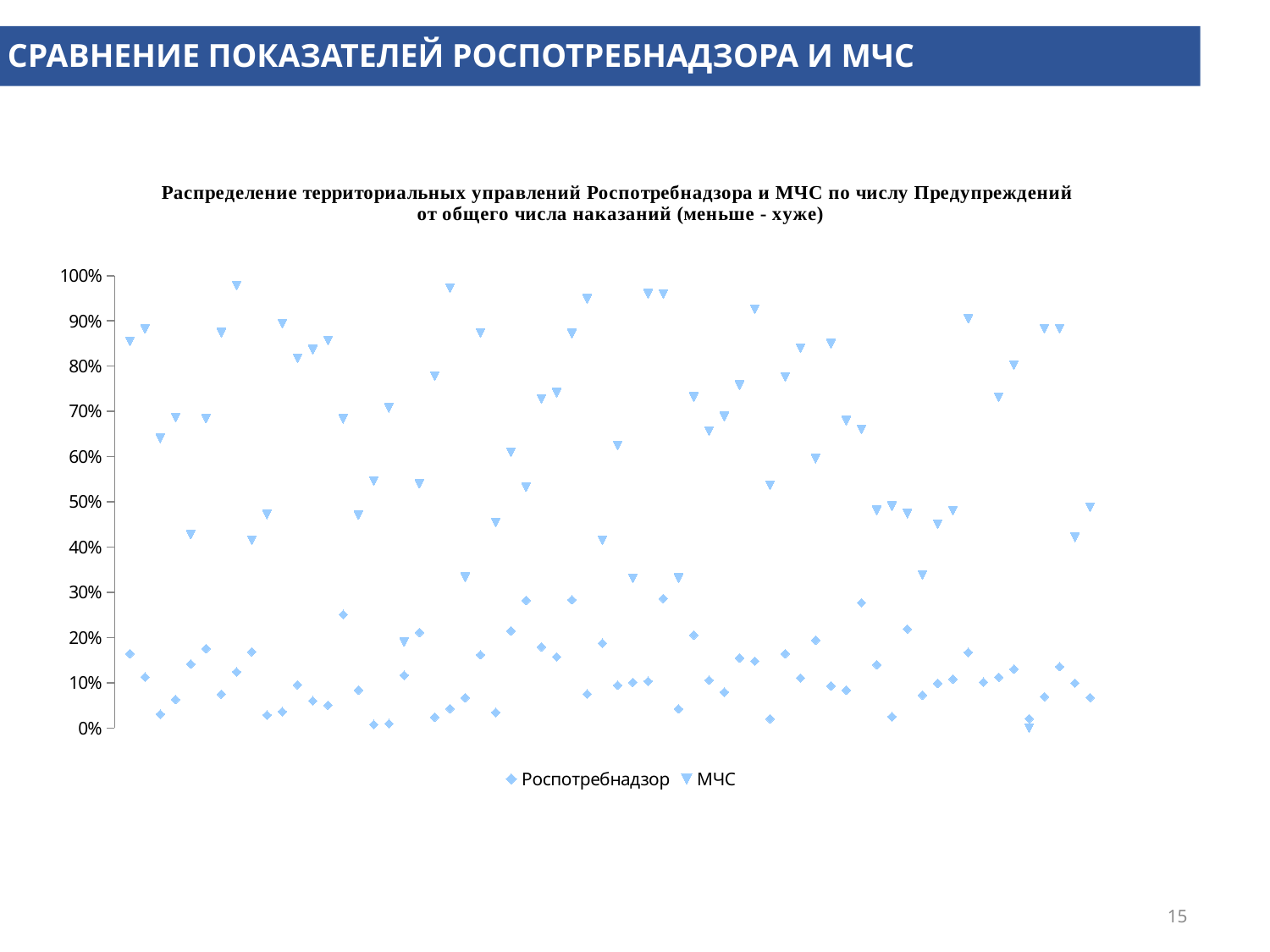
Is the lowest value for МЧС greater or less than 10%? less Is the lowest value for Роспотребнадзор greater or less than 5%? less How many series does the legend list? 2 Is the highest value for МЧС greater or less than 90%? greater What is the title of the chart? Распределение территориальных управлений Роспотребнадзора и МЧС по числу Предупреждений от общего числа наказаний (меньше - хуже) What are the two series named in the legend? Роспотребнадзор and МЧС Which series contains the highest plotted point on the chart? МЧС Which series generally has higher values, Роспотребнадзор or МЧС? МЧС What kind of chart is shown on the slide? scatter chart